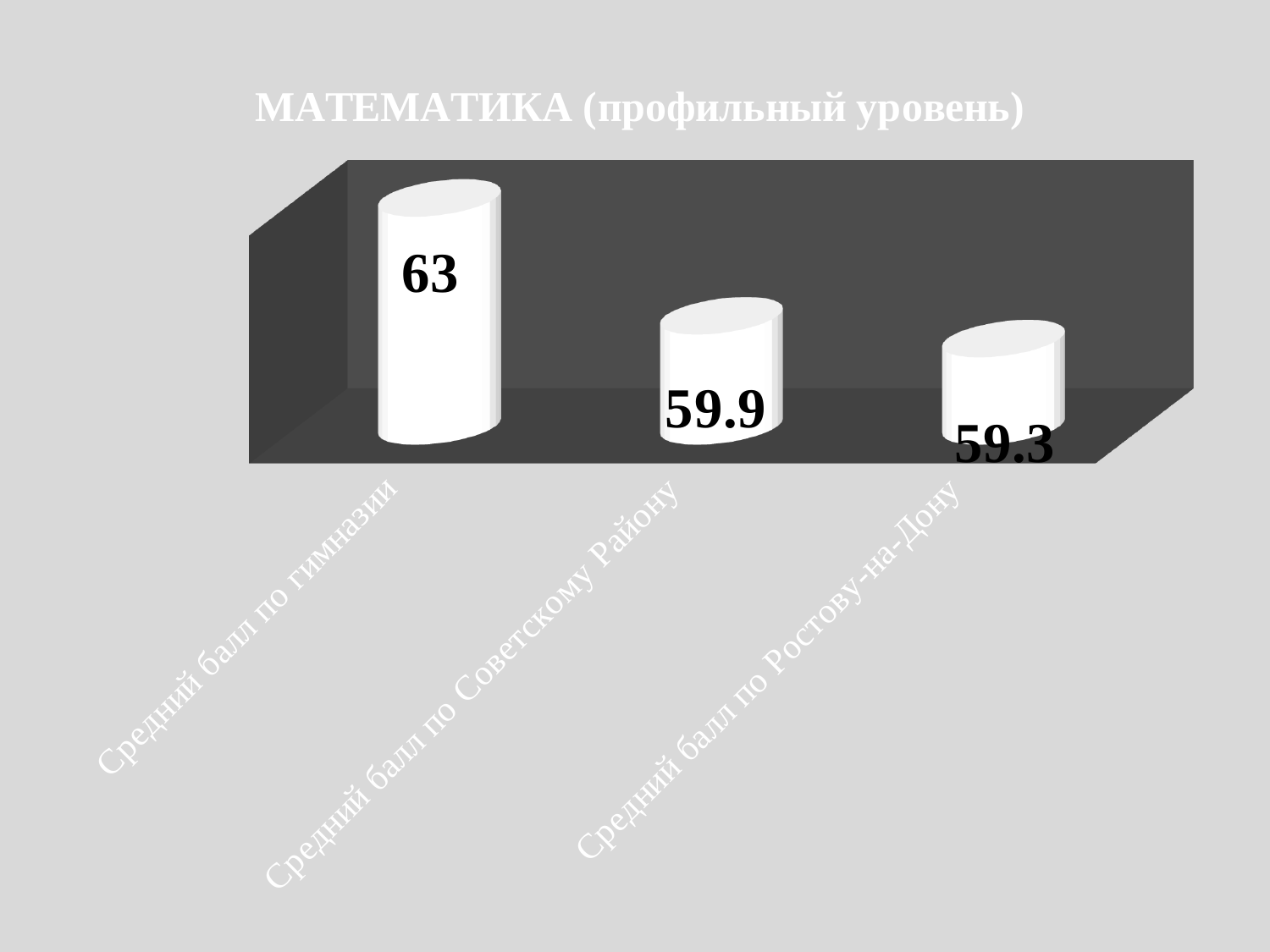
How many categories are shown in the chart? 3 What is the value for Средний балл по Ростову-на-Дону? 59.3 What is the value for Средний балл по Советскому Району? 59.9 What is the difference between the value for Средний балл по гимназии and the value for Средний балл по Советскому Району? 3.1 Which category has the highest value? Средний балл по гимназии Which is larger: the value for Средний балл по Советскому Району or the value for Средний балл по Ростову-на-Дону? Средний балл по Советскому Району What is the title of the chart? МАТЕМАТИКА (профильный уровень) Which category has the lowest value? Средний балл по Ростову-на-Дону Do the values rise or fall from left to right along the x axis? Fall What is the value for Средний балл по гимназии? 63 What kind of chart is shown on the slide? Bar chart What is the difference between the value for Средний балл по гимназии and the value for Средний балл по Ростову-на-Дону? 3.7